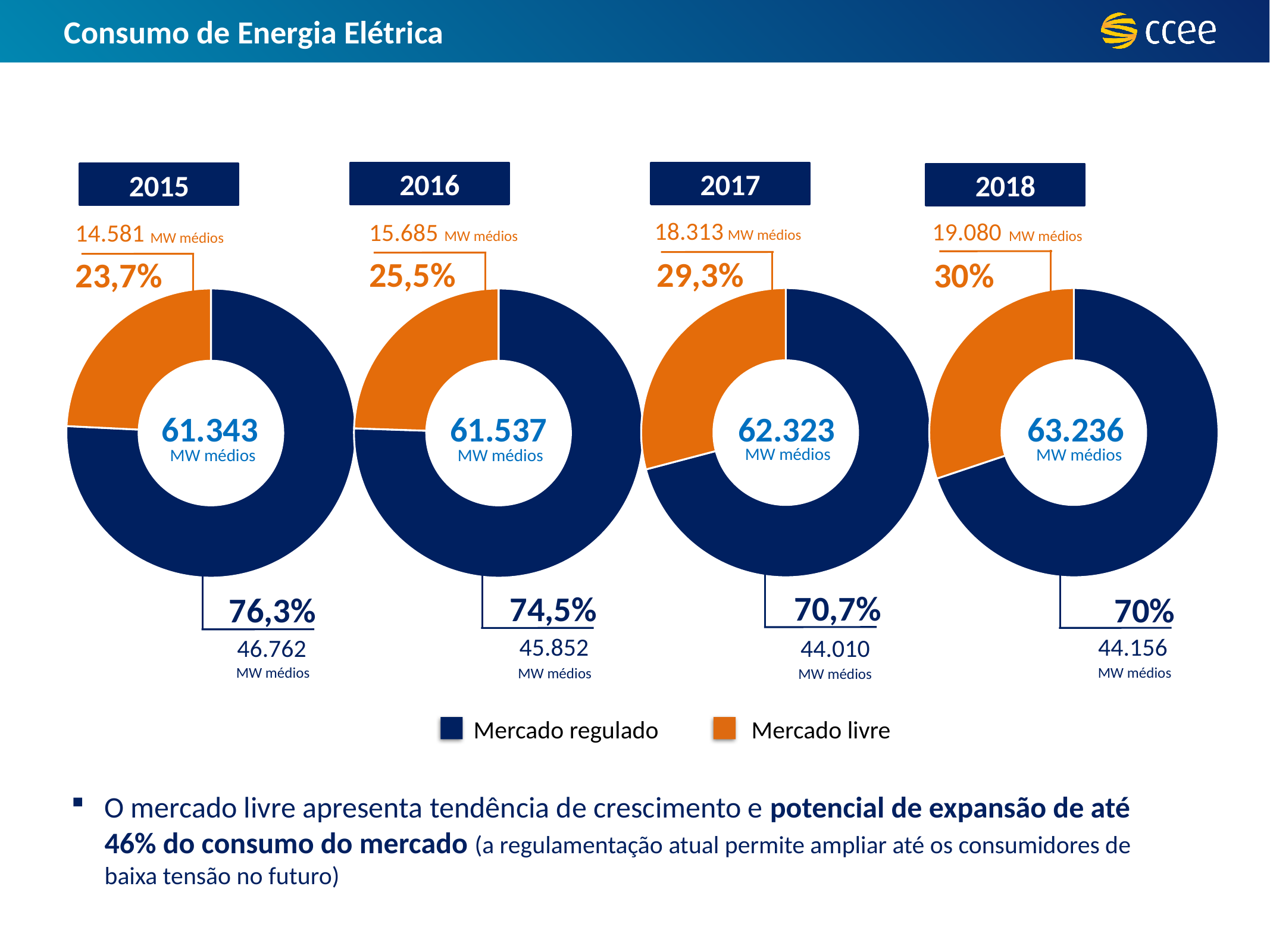
In the 2015 chart, what is the value for Mercado livre? 14.581 MW médios How many donut charts are shown on the slide? 4 In the 2017 chart, what is the total shown in the centre of the donut? 62.323 MW médios In the 2017 chart, what is the difference between the Mercado regulado and Mercado livre values? 25.697 MW médios Which year's chart shows the lowest total consumption in the centre of the donut? 2015 Across the charts from 2015 to 2018, does the Mercado livre share rise or fall? rise In the 2018 chart, what share of the donut does Mercado regulado represent? 70% In the 2015 chart, which is larger, Mercado regulado or Mercado livre? Mercado regulado Which year's chart shows the highest Mercado livre share? 2018 In the 2018 chart, what is the value for Mercado regulado? 44.156 MW médios In the 2016 chart, what share of the donut does Mercado livre represent? 25,5% How many series does the legend list? 2